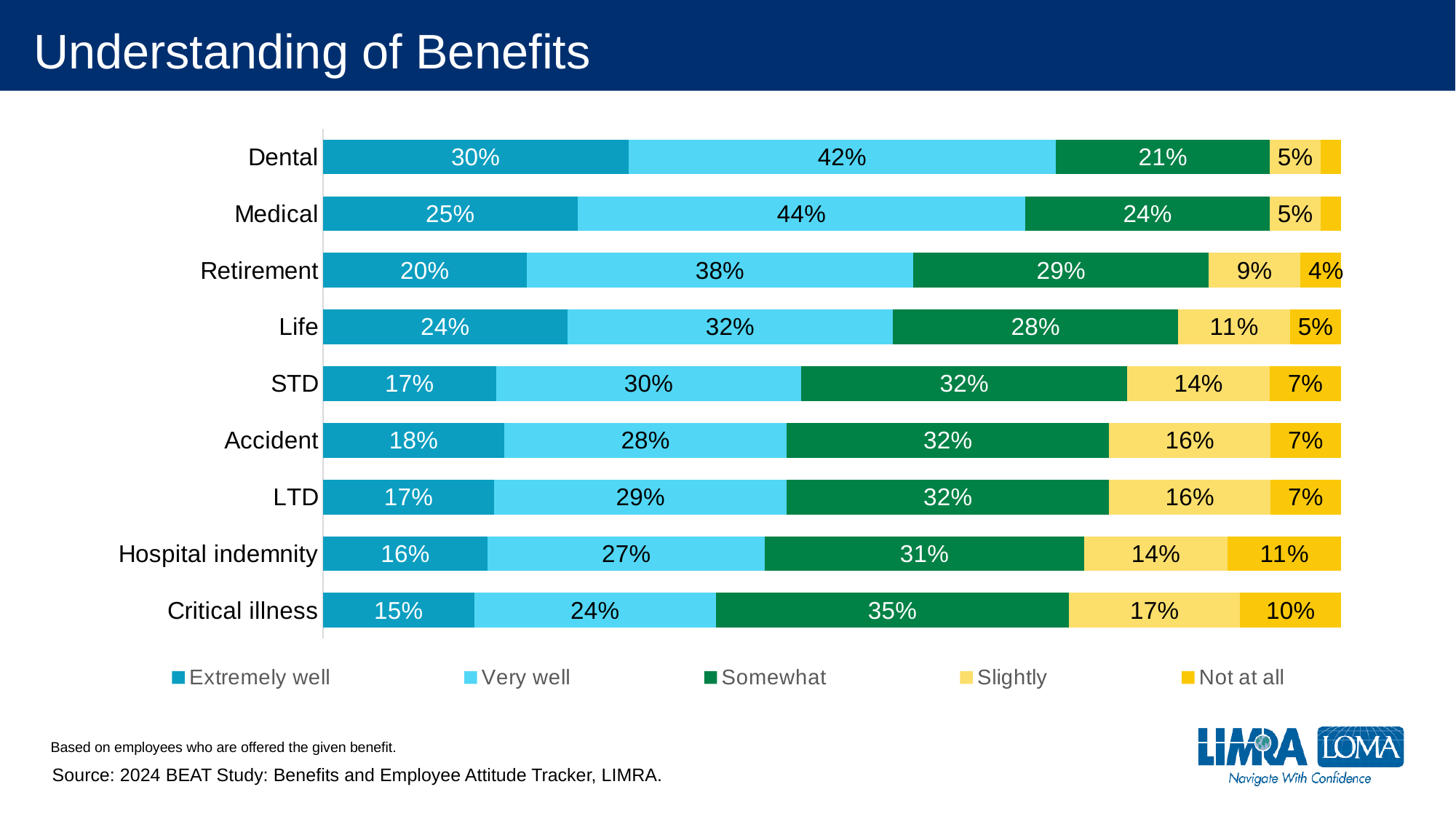
What is the 'Somewhat' value for Critical illness? 35% How many series does the legend list? 5 Which has the larger 'Somewhat' value, Retirement or Life? Retirement What is the total of the labelled segments in the Retirement bar? 100% What is the 'Slightly' value for Accident? 16% Which benefit has the lowest 'Extremely well' percentage? Critical illness What percentage of employees say they understand their Dental benefit extremely well? 30% Which benefit has the highest 'Not at all' percentage? Hospital indemnity What kind of chart is shown on the slide? Stacked bar chart How many percentage points higher is the 'Very well' value for Medical than for Dental? 2 percentage points How many benefit categories are shown on the chart? 9 Which benefit has the highest 'Extremely well' percentage? Dental